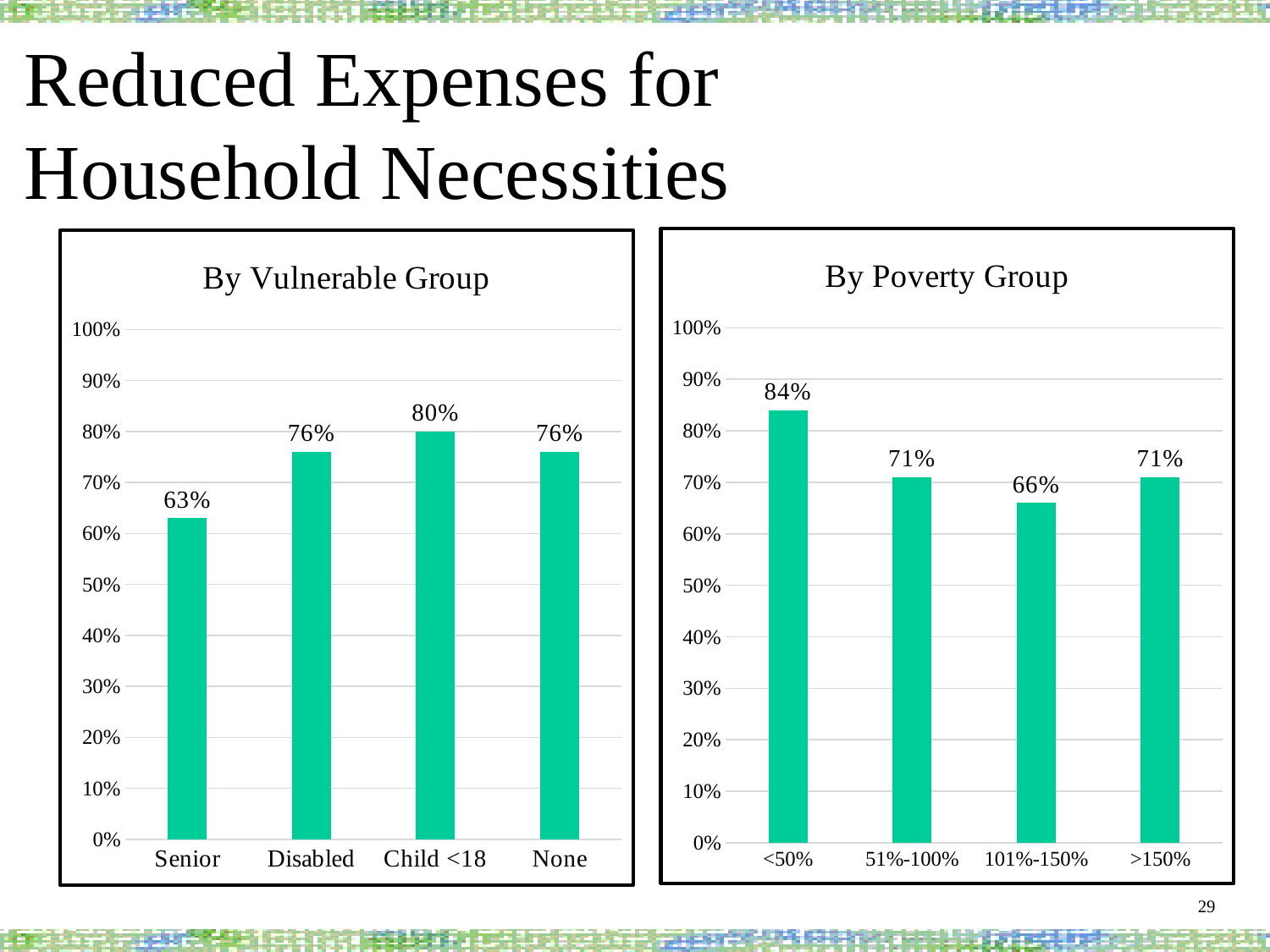
In the 'By Vulnerable Group' chart, what is the difference between the values for Child <18 and Senior? 17% In the 'By Poverty Group' chart, which category has the highest value? <50% In the 'By Vulnerable Group' chart, which category has the lowest value? Senior In the 'By Vulnerable Group' chart, is the value for Disabled greater or less than 70%? greater In the 'By Poverty Group' chart, what is the difference between the values for <50% and 51%-100%? 13% What kind of chart is the 'By Poverty Group' chart? Bar chart In the 'By Poverty Group' chart, which category has the lowest value? 101%-150% In the 'By Vulnerable Group' chart, which category has the highest value? Child <18 In the 'By Poverty Group' chart, which is larger, the value for <50% or the value for >150%? <50% In the 'By Poverty Group' chart, what is the value for 101%-150%? 66% In the 'By Vulnerable Group' chart, how many categories are shown? 4 In the 'By Vulnerable Group' chart, what is the value for Senior? 63%